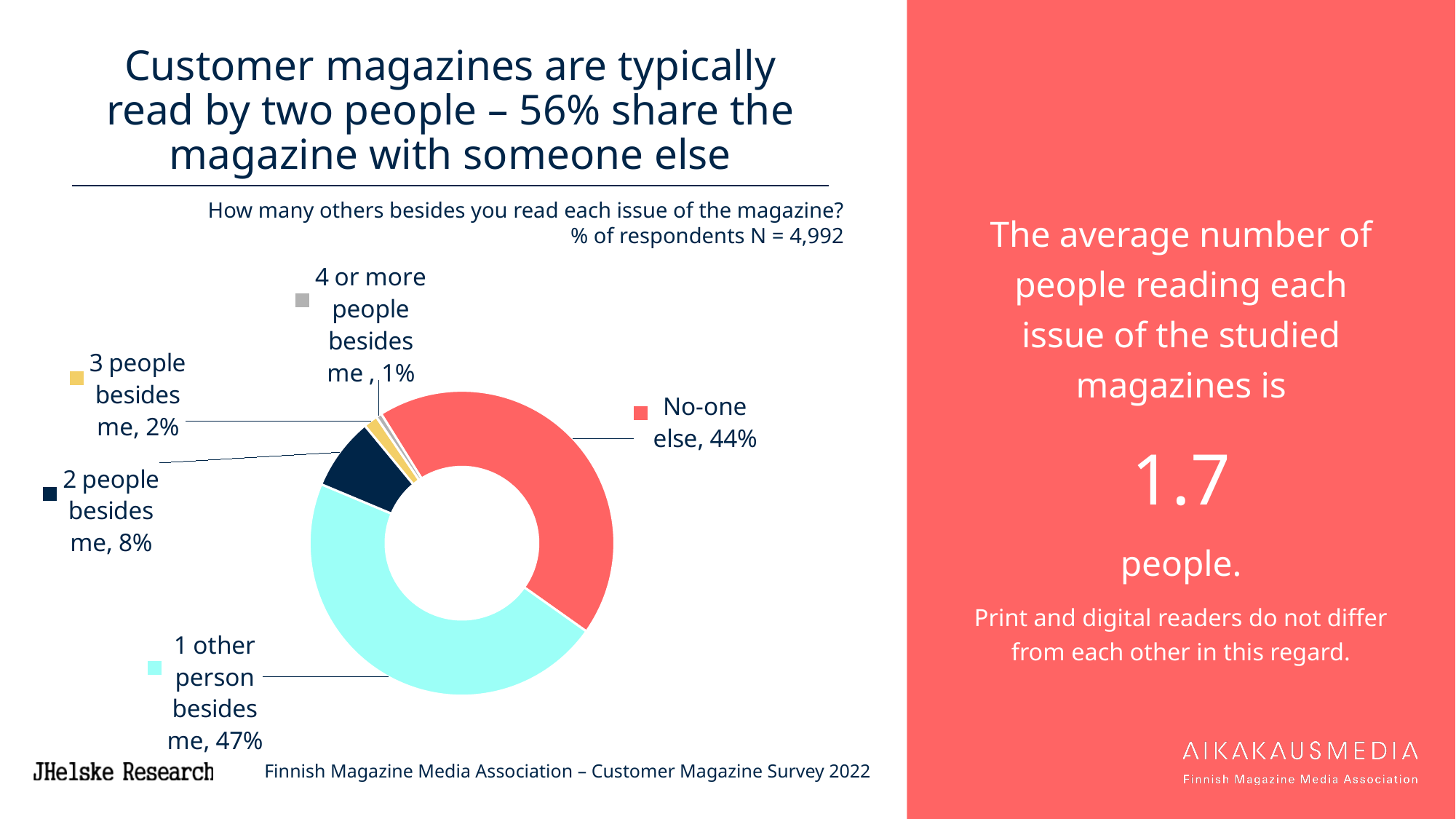
What percentage of respondents said 4 or more people besides them read the magazine? 1% Which is larger: the share for '2 people besides me' or '3 people besides me'? 2 people besides me What percentage of respondents said 3 people besides them read the magazine? 2% What percentage of respondents said 2 people besides them read the magazine? 8% Which category has the smallest share of respondents? 4 or more people besides me What percentage of respondents said 1 other person besides them reads the magazine? 47% What kind of chart is shown on the slide? Pie chart (doughnut) Which category has the largest share of respondents? 1 other person besides me What is the number of respondents (N) stated for the chart? 4,992 What percentage of respondents said no-one else reads the magazine? 44% How many categories are shown in the chart? 5 What is the difference in percentage points between '1 other person besides me' and 'No-one else'? 3